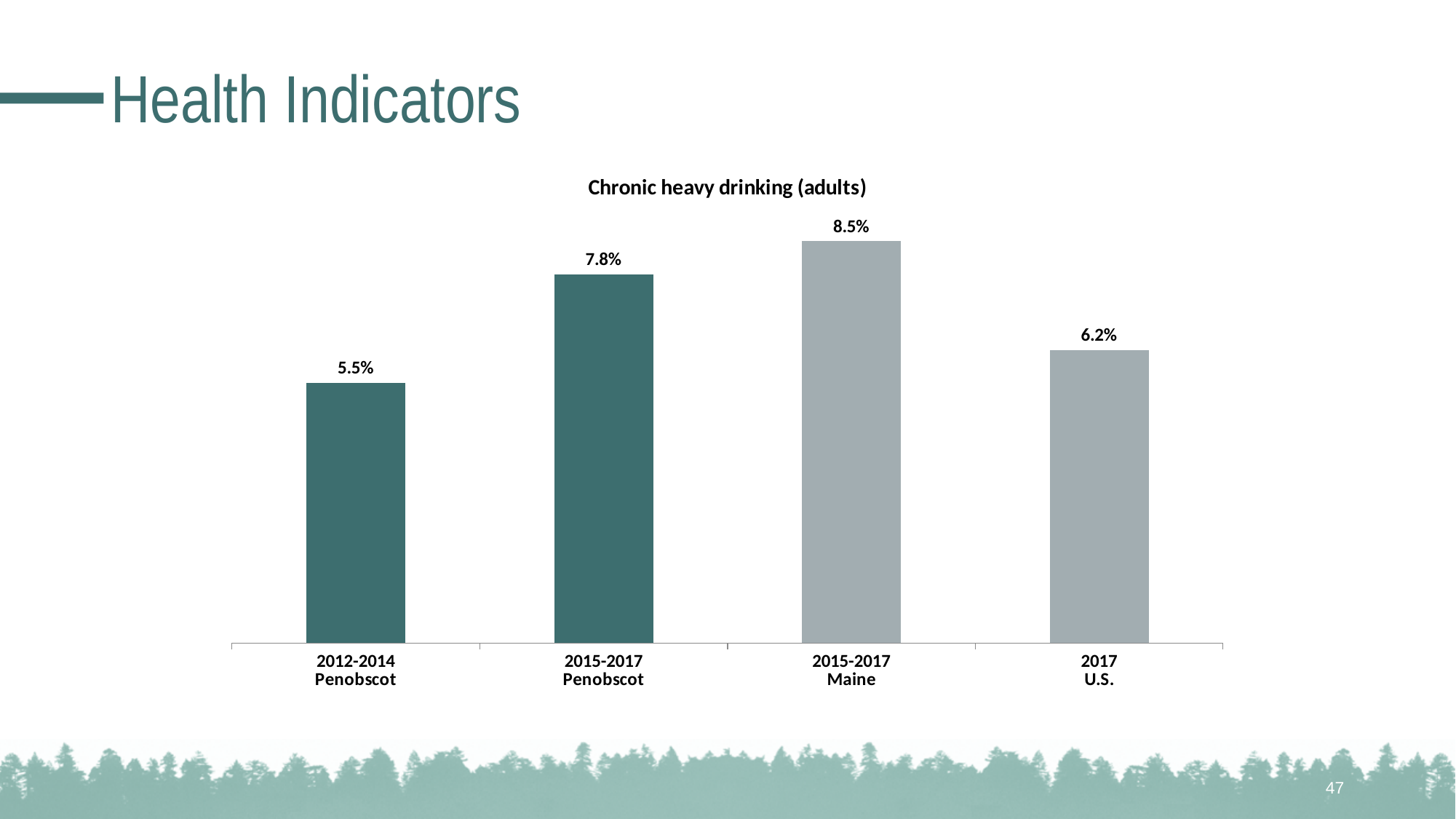
What is the value for 2017 U.S.? 6.2% What is the value for 2015-2017 Maine? 8.5% What is the value for 2015-2017 Penobscot? 7.8% What is the title of the chart? Chronic heavy drinking (adults) What is the value for 2012-2014 Penobscot? 5.5% Which is larger, the value for 2015-2017 Penobscot or the value for 2017 U.S.? 2015-2017 Penobscot What is the difference between the 2015-2017 Penobscot value and the 2012-2014 Penobscot value? 2.3% How many bars are shown in the chart? 4 What kind of chart is shown on the slide? Bar chart Which category has the lowest value? 2012-2014 Penobscot Which category has the highest value? 2015-2017 Maine What is the difference between the 2015-2017 Maine value and the 2015-2017 Penobscot value? 0.7%